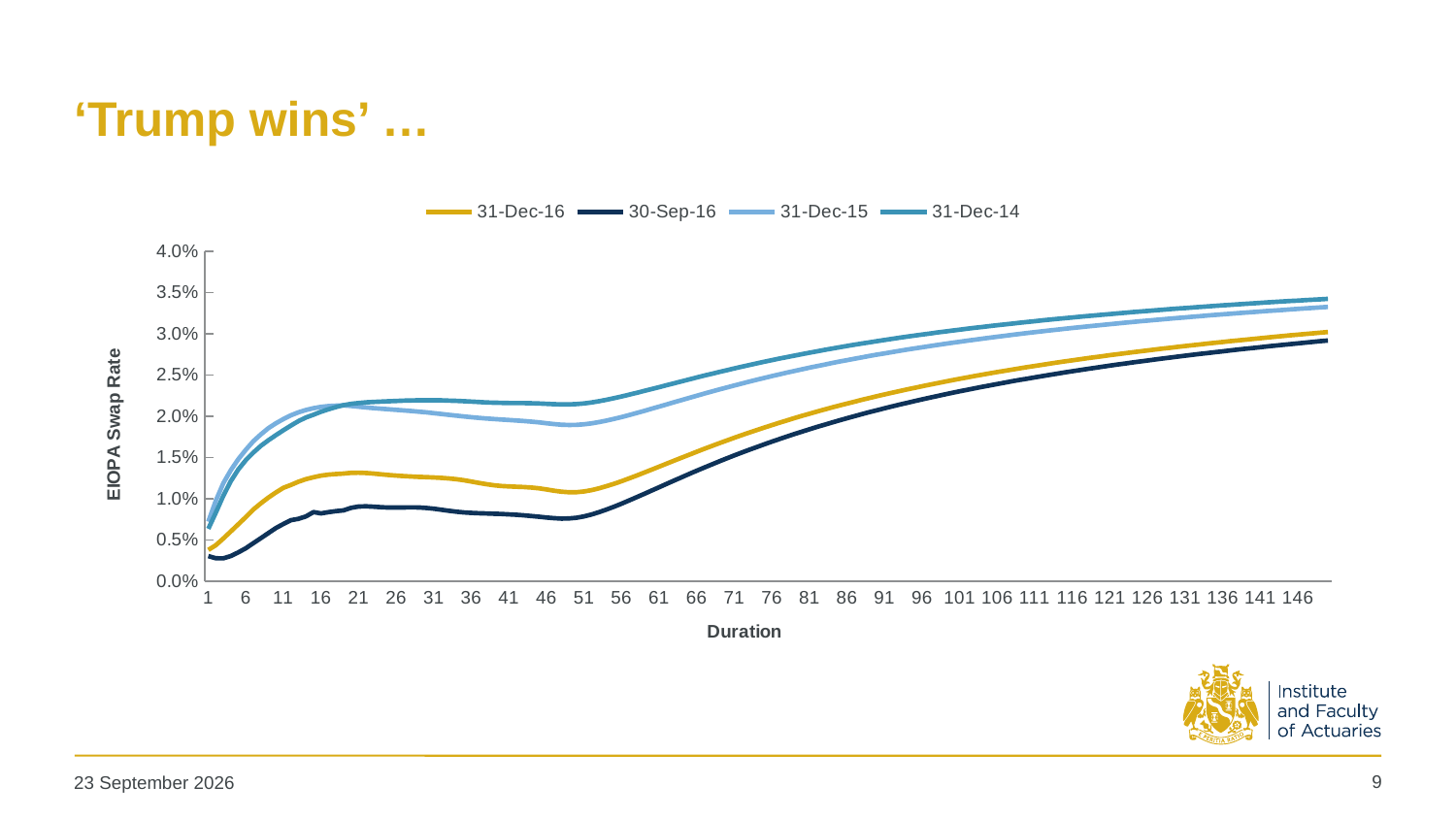
Is the value for 31-Dec-16 at duration 21 greater or less than 1.0%? greater Is the value for 31-Dec-14 at duration 146 greater or less than 3.0%? greater Which series has the lowest value at duration 101? 30-Sep-16 What is the title of the horizontal axis? Duration Is the value for 30-Sep-16 at duration 1 greater or less than 0.5%? less At duration 11, which is larger: the value for 31-Dec-15 or the value for 31-Dec-16? 31-Dec-15 Which series has the lowest values across the chart? 30-Sep-16 How many series does the legend list? 4 What is the title of the vertical axis? EIOPA Swap Rate What kind of chart is shown on the slide? line chart Does the 30-Sep-16 series rise or fall between duration 51 and duration 146? rise